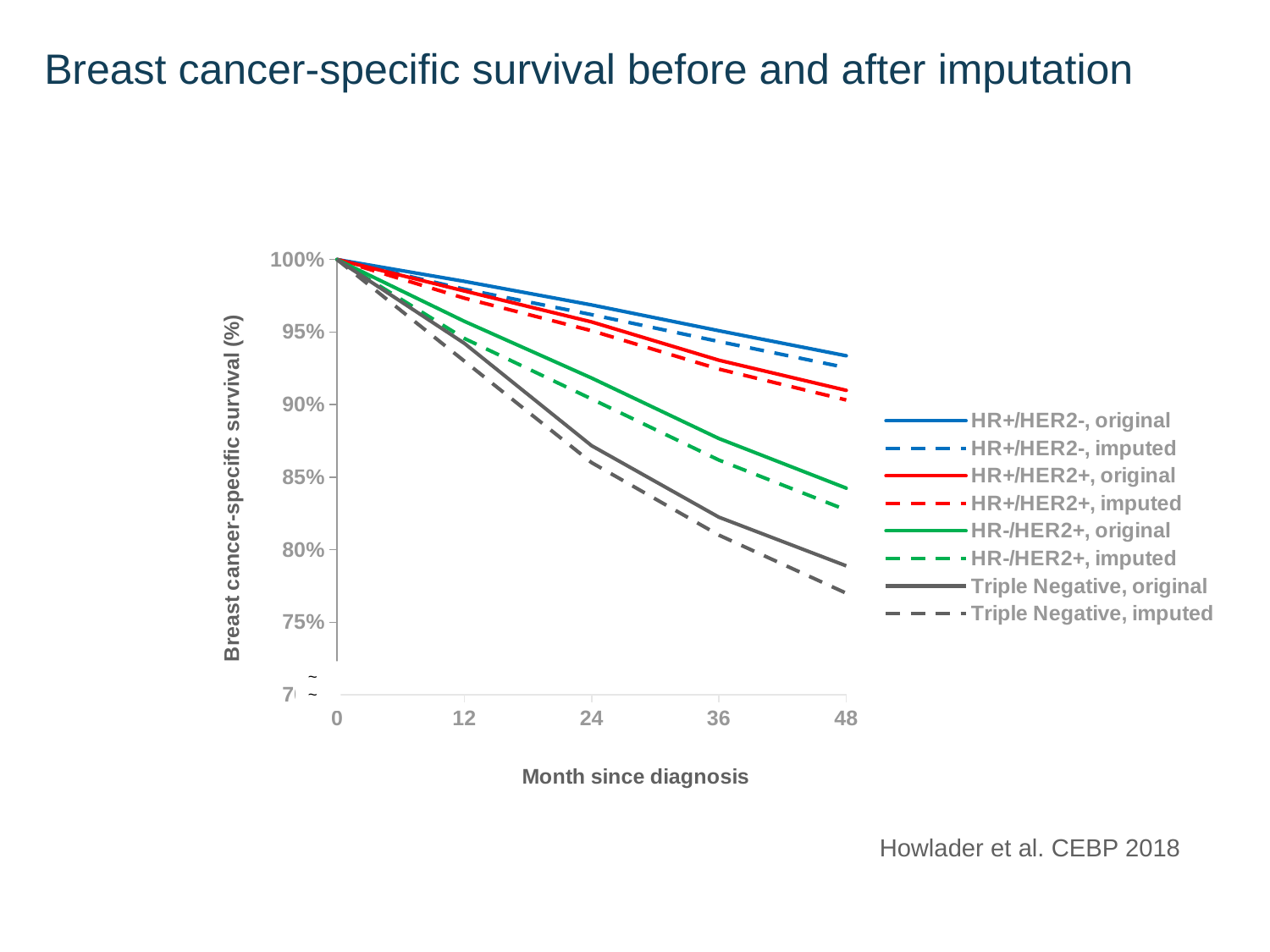
Which series has the lowest survival at 48 months since diagnosis? Triple Negative, imputed Do the survival values rise or fall as months since diagnosis increase? fall What is the title of the x axis? Month since diagnosis What kind of chart is shown on the slide? line chart How many series does the legend list? 8 What line style is used for the imputed series in the legend? dashed Is the value for HR+/HER2-, original at 48 months greater or less than 90%? greater Is the value for HR-/HER2+, imputed at 48 months greater or less than 85%? less At 48 months, which is higher: Triple Negative, original or Triple Negative, imputed? Triple Negative, original What is the breast cancer-specific survival for HR+/HER2-, original at month 0? 100% Is the value for Triple Negative, original at 48 months greater or less than 80%? less Which series has the highest survival at 48 months since diagnosis? HR+/HER2-, original